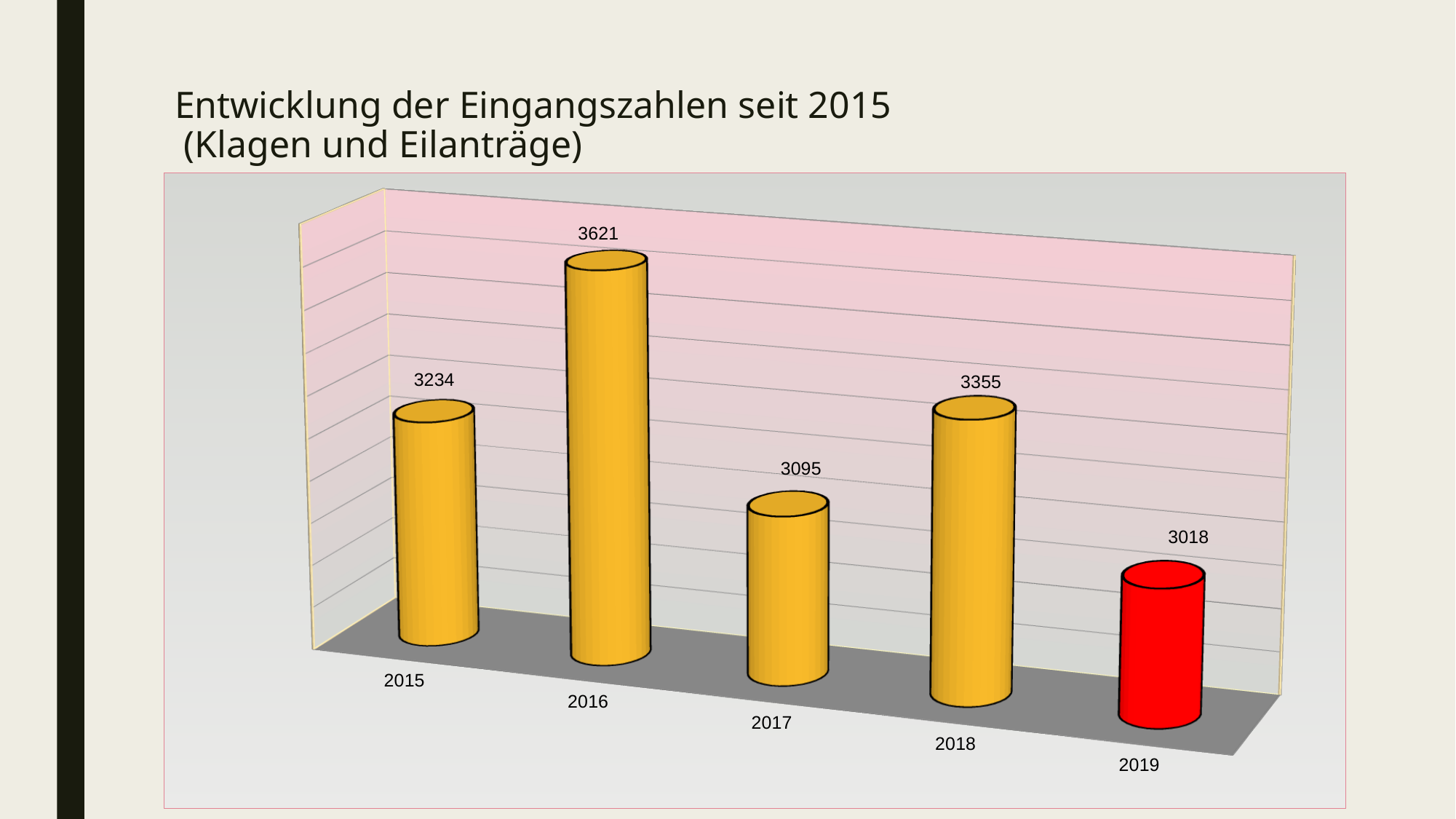
What is the value for 2019? 3018 Which year has the highest value? 2016 Which year's bar is coloured red? 2019 What is the value for 2016? 3621 What kind of chart is shown on the slide? bar chart How many years are shown on the chart? 5 Which is larger, the value for 2015 or the value for 2018? 2018 What is the difference between the values for 2015 and 2019? 216 What is the value for 2017? 3095 What is the difference between the values for 2016 and 2017? 526 Which year has the lowest value? 2019 Does the value fall or rise from 2018 to 2019? fall